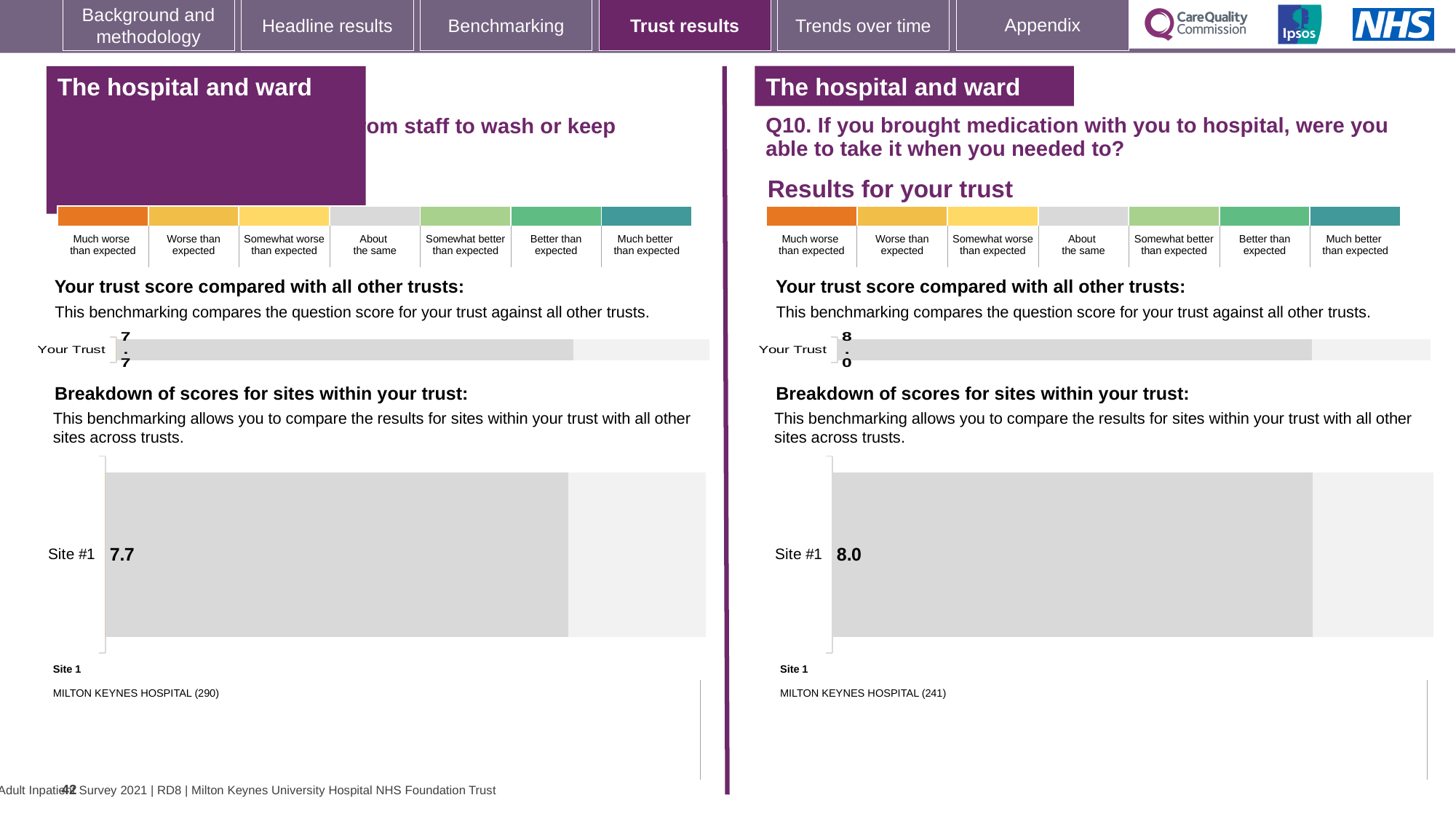
What is the difference between the Site #1 score in the Q10 breakdown chart on the right and the Site #1 score in the breakdown chart on the left? 0.3 Comparing the Site #1 scores in the two breakdown charts, which half of the slide shows the larger score, the left or the right (Q10)? right (Q10) How many sites are shown in the 'Breakdown of scores for sites within your trust' chart on the left half of the slide? 1 In the 'Breakdown of scores for sites within your trust' chart on the left half of the slide, what is the score for Site #1? 7.7 In the 'Your trust score compared with all other trusts' chart for Q10 on the right half of the slide, what is the score for Your Trust? 8.0 In the 'Your trust score compared with all other trusts' chart on the left half of the slide, what is the score for Your Trust? 7.7 What is the label of the single category in the 'Your trust score compared with all other trusts' chart on the left half of the slide? Your Trust In the 'Breakdown of scores for sites within your trust' chart for Q10 on the right half of the slide, what is the score for Site #1? 8.0 In the breakdown chart on the right half of the slide, which hospital is listed as Site 1? MILTON KEYNES HOSPITAL What kind of chart is used for the 'Breakdown of scores for sites within your trust' on the right half of the slide? bar chart